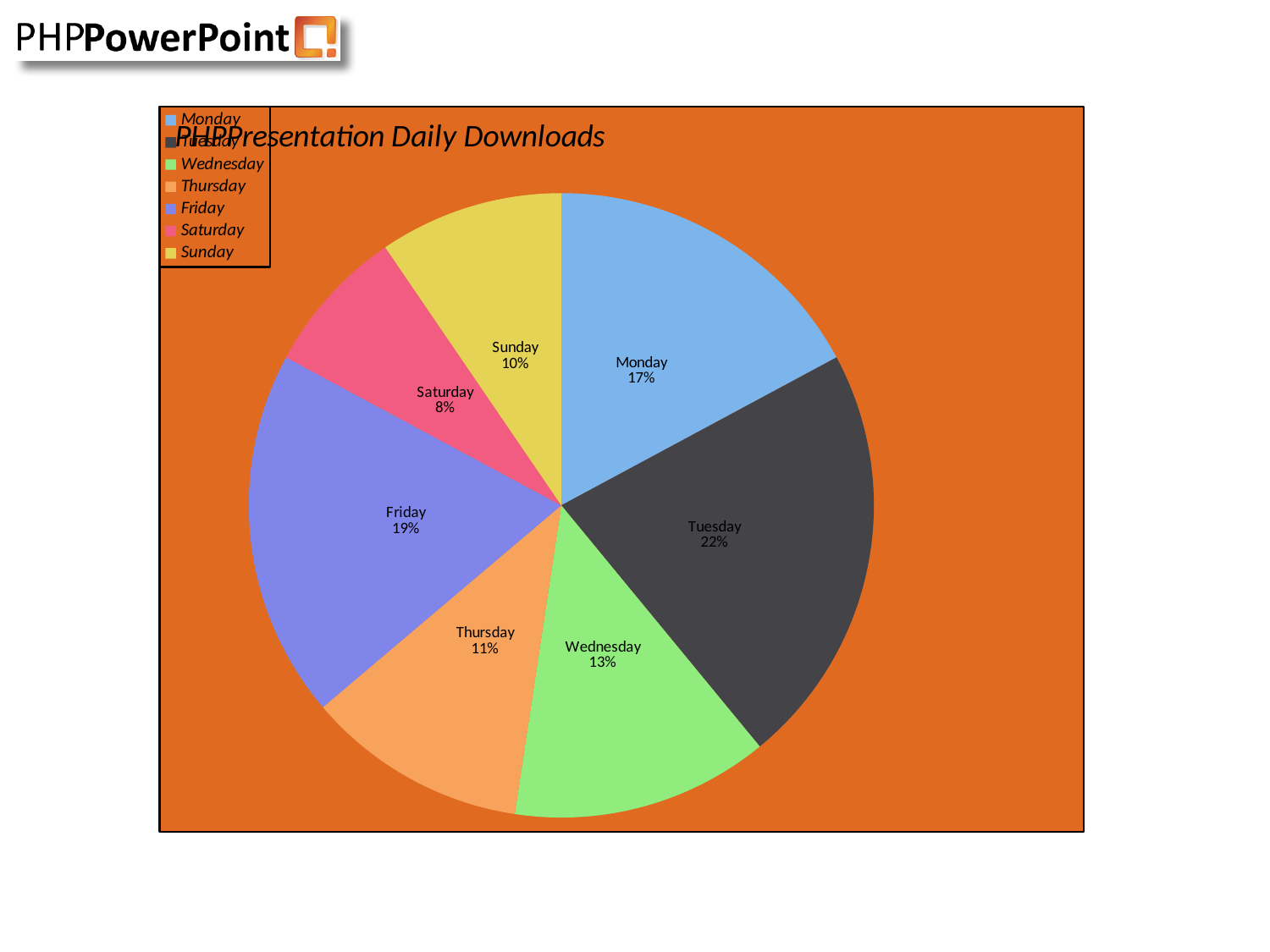
What kind of chart is shown on the slide? pie chart What share of the pie does Wednesday have? 13% What is the combined share of Saturday and Sunday? 18% What share of the pie does Friday have? 19% What is the difference in percentage points between Tuesday and Sunday? 12 What share of the pie does Saturday have? 8% Which day has the largest slice of the pie? Tuesday How many slices does the pie chart have? 7 Which is larger, the share for Monday or the share for Thursday? Monday Which day has the smallest slice of the pie? Saturday What is the title of the chart? PHPPresentation Daily Downloads